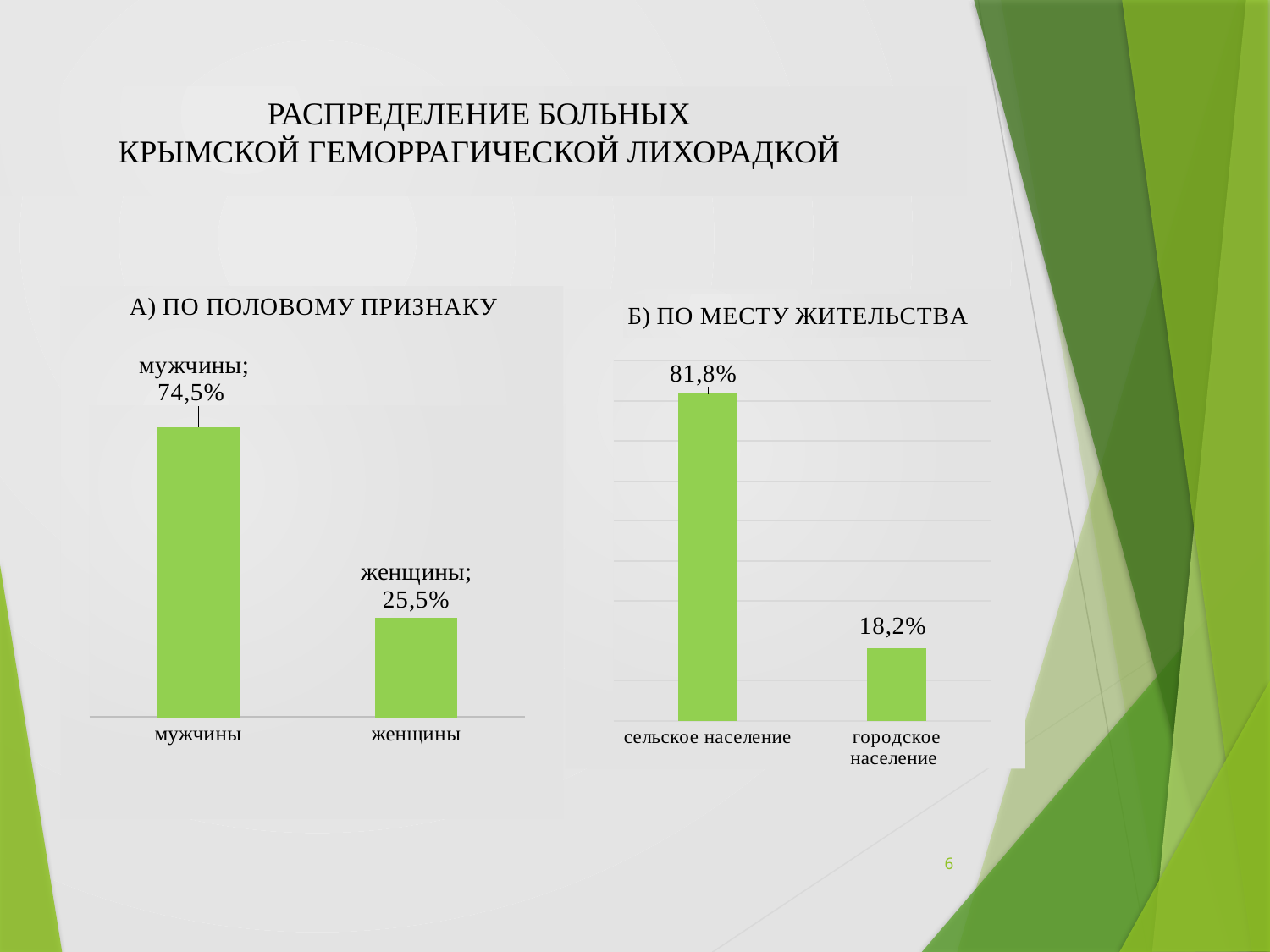
In the chart "А) ПО ПОЛОВОМУ ПРИЗНАКУ" (left), what is the value for мужчины? 74,5% How many categories are shown in the chart "А) ПО ПОЛОВОМУ ПРИЗНАКУ" (left)? 2 In the chart "А) ПО ПОЛОВОМУ ПРИЗНАКУ" (left), what is the difference between the values for мужчины and женщины? 49,0% In the chart "Б) ПО МЕСТУ ЖИТЕЛЬСТВА" (right), what is the difference between the values for сельское население and городское население? 63,6% In the chart "Б) ПО МЕСТУ ЖИТЕЛЬСТВА" (right), what is the value for городское население? 18,2% In the chart "Б) ПО МЕСТУ ЖИТЕЛЬСТВА" (right), which category has the lowest value? городское население What kind of chart is "Б) ПО МЕСТУ ЖИТЕЛЬСТВА" (right)? bar chart In the chart "А) ПО ПОЛОВОМУ ПРИЗНАКУ" (left), what is the value for женщины? 25,5% In the chart "Б) ПО МЕСТУ ЖИТЕЛЬСТВА" (right), what is the value for сельское население? 81,8% In the chart "А) ПО ПОЛОВОМУ ПРИЗНАКУ" (left), which category has the highest value? мужчины In the chart "Б) ПО МЕСТУ ЖИТЕЛЬСТВА" (right), which is larger: сельское население or городское население? сельское население What is the title of the chart on the left of the slide? А) ПО ПОЛОВОМУ ПРИЗНАКУ